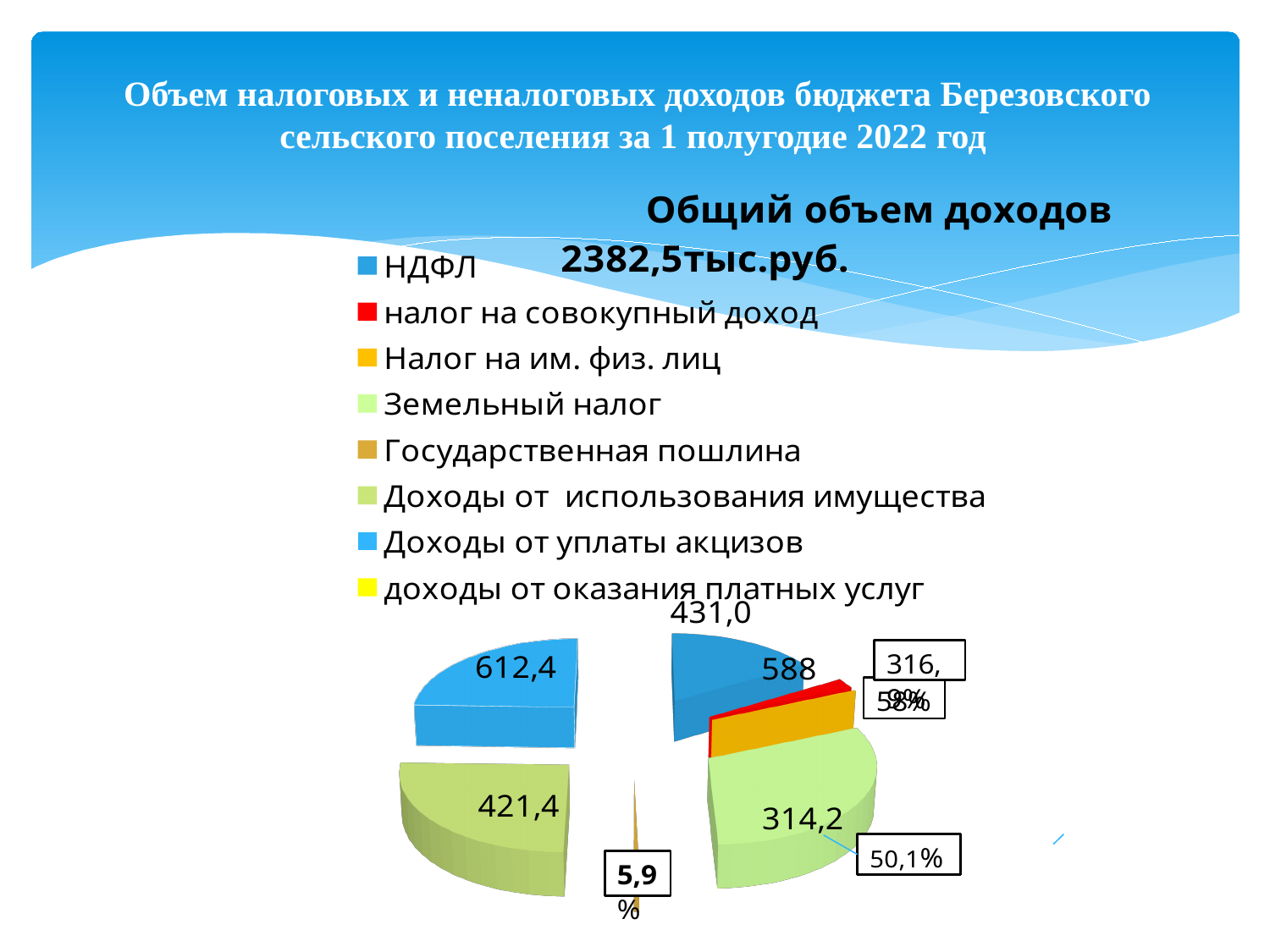
Which is larger in the pie chart: Доходы от уплаты акцизов or Доходы от использования имущества? Доходы от уплаты акцизов What is the difference between the values for Доходы от уплаты акцизов and Доходы от использования имущества? 191,0 What is the title of the slide containing the pie chart? Объем налоговых и неналоговых доходов бюджета Березовского сельского поселения за 1 полугодие 2022 год What value is shown for Доходы от уплаты акцизов in the pie chart? 612,4 What value is shown for Доходы от использования имущества in the pie chart? 421,4 How many entries does the legend of the pie chart list? 8 What value is shown for Земельный налог in the pie chart? 314,2 What kind of chart is shown on the slide? pie chart What is the difference between the values for Доходы от использования имущества and Земельный налог? 107,2 What colour does the legend use for налог на совокупный доход? red Which is larger in the pie chart: Доходы от использования имущества or Земельный налог? Доходы от использования имущества